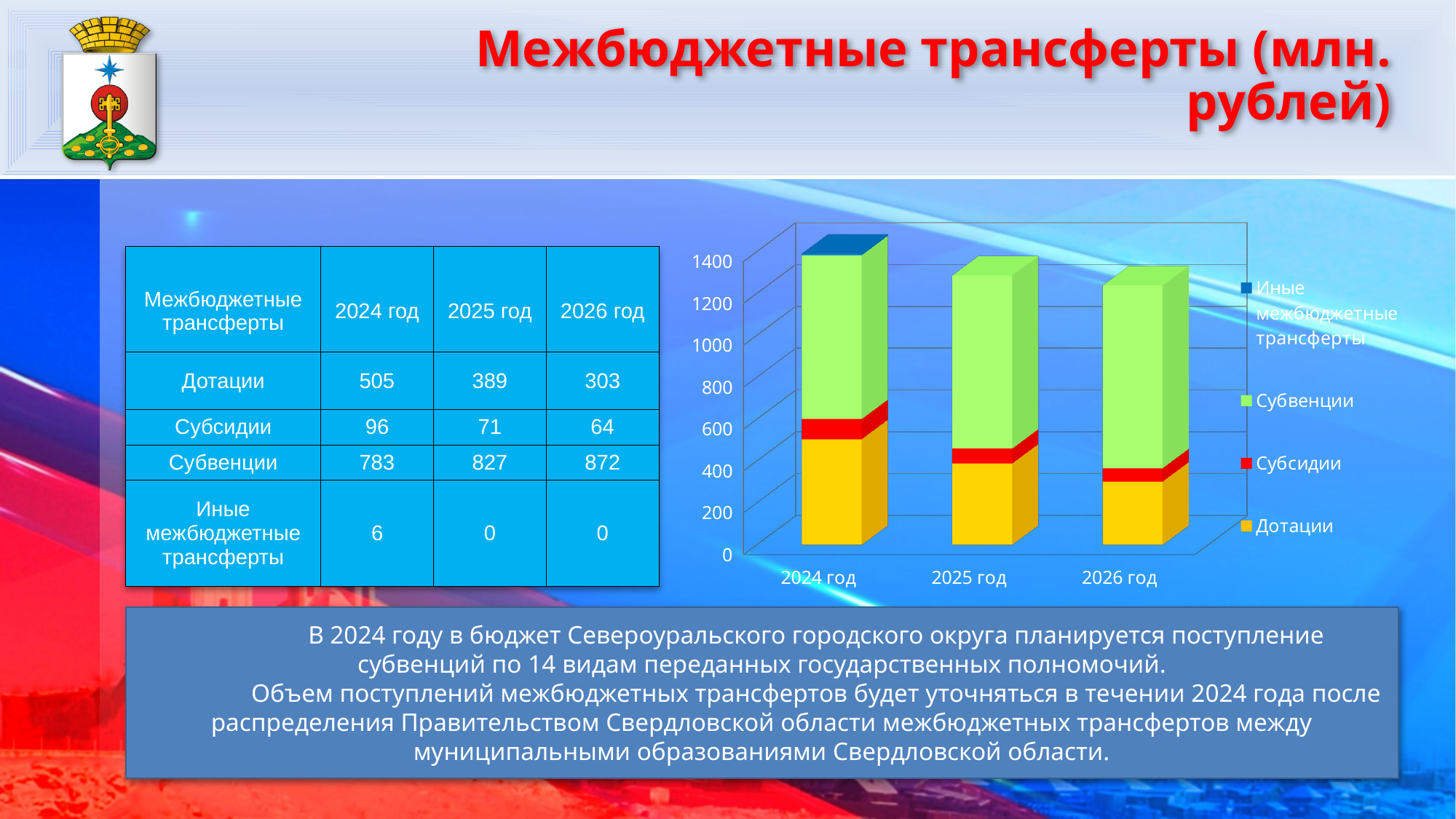
What is the total height of the stacked bar for 2026 год? 1239 Is the total of the stacked bar for 2024 год greater or less than 1200? greater What kind of chart is shown on the slide? stacked bar chart What is the value of Субвенции for 2026 год? 872 Which year has the highest value for Дотации? 2024 год What is the value of Субсидии for 2025 год? 71 How many years (categories) are shown on the x axis of the chart? 3 What is the value of Дотации for 2024 год? 505 What is the total height of the stacked bar for 2024 год? 1390 What is the difference between Субвенции in 2026 год and 2024 год? 89 Do the values for Субвенции rise or fall from 2024 год to 2026 год? rise How many series does the chart legend list? 4